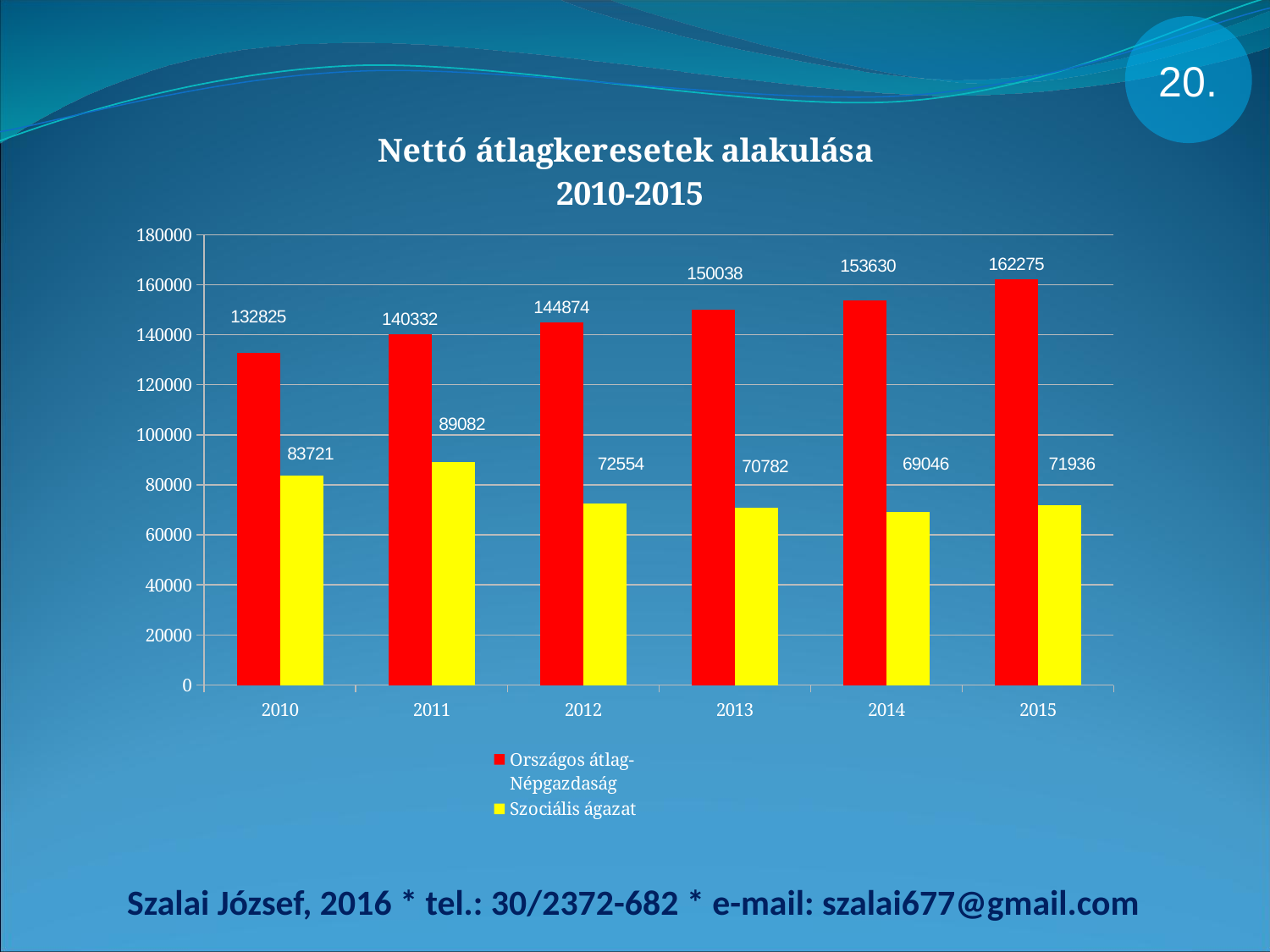
How many years are shown on the x axis? 6 How many series does the legend list? 2 What is the value for Szociális ágazat in 2014? 69046 In which year is the Országos átlag-Népgazdaság value lowest? 2010 Does the Országos átlag-Népgazdaság series rise or fall from 2010 to 2015? rise What is the value for Országos átlag-Népgazdaság in 2015? 162275 What is the value for Szociális ágazat in 2011? 89082 What kind of chart is shown on the slide? bar chart Which is larger: Szociális ágazat in 2012 or Szociális ágazat in 2013? 2012 What is the difference between Országos átlag-Népgazdaság and Szociális ágazat in 2015? 90339 In which year is the Szociális ágazat value highest? 2011 In which year is the Szociális ágazat value lowest? 2014